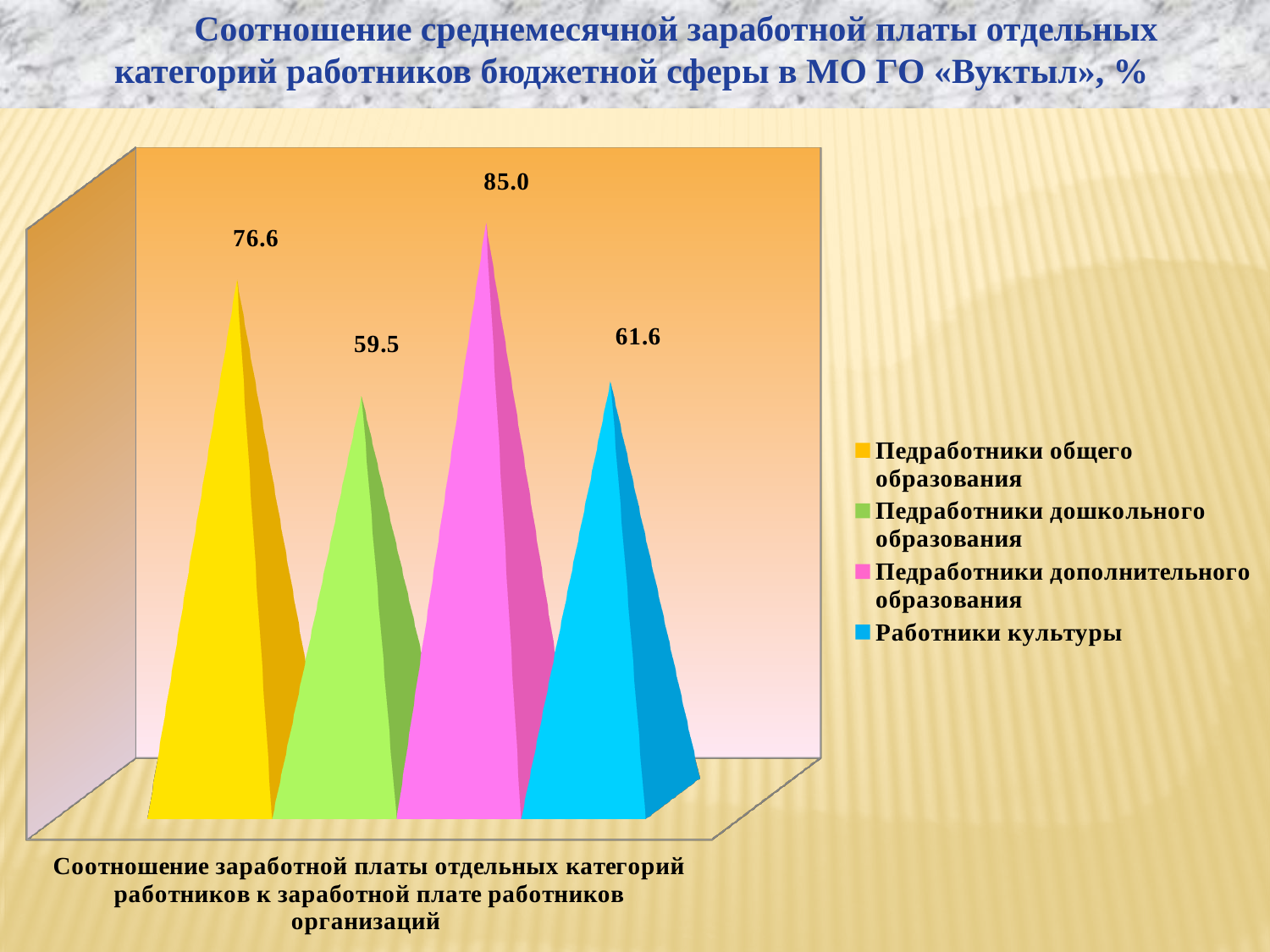
What kind of chart is shown on the slide? Bar chart Which category has the highest value? Педработники дополнительного образования How many series does the legend list? 4 Which category has the lowest value? Педработники дошкольного образования What is the difference between the values for Работники культуры and Педработники дошкольного образования? 2.1 What is the value for Педработники дошкольного образования? 59.5 What colour represents Работники культуры in the legend? Blue What is the difference between the values for Педработники дополнительного образования and Педработники общего образования? 8.4 What is the value for Работники культуры? 61.6 What is the value for Педработники дополнительного образования? 85.0 Which is larger: the value for Педработники общего образования or the value for Работники культуры? Педработники общего образования What is the value for Педработники общего образования? 76.6